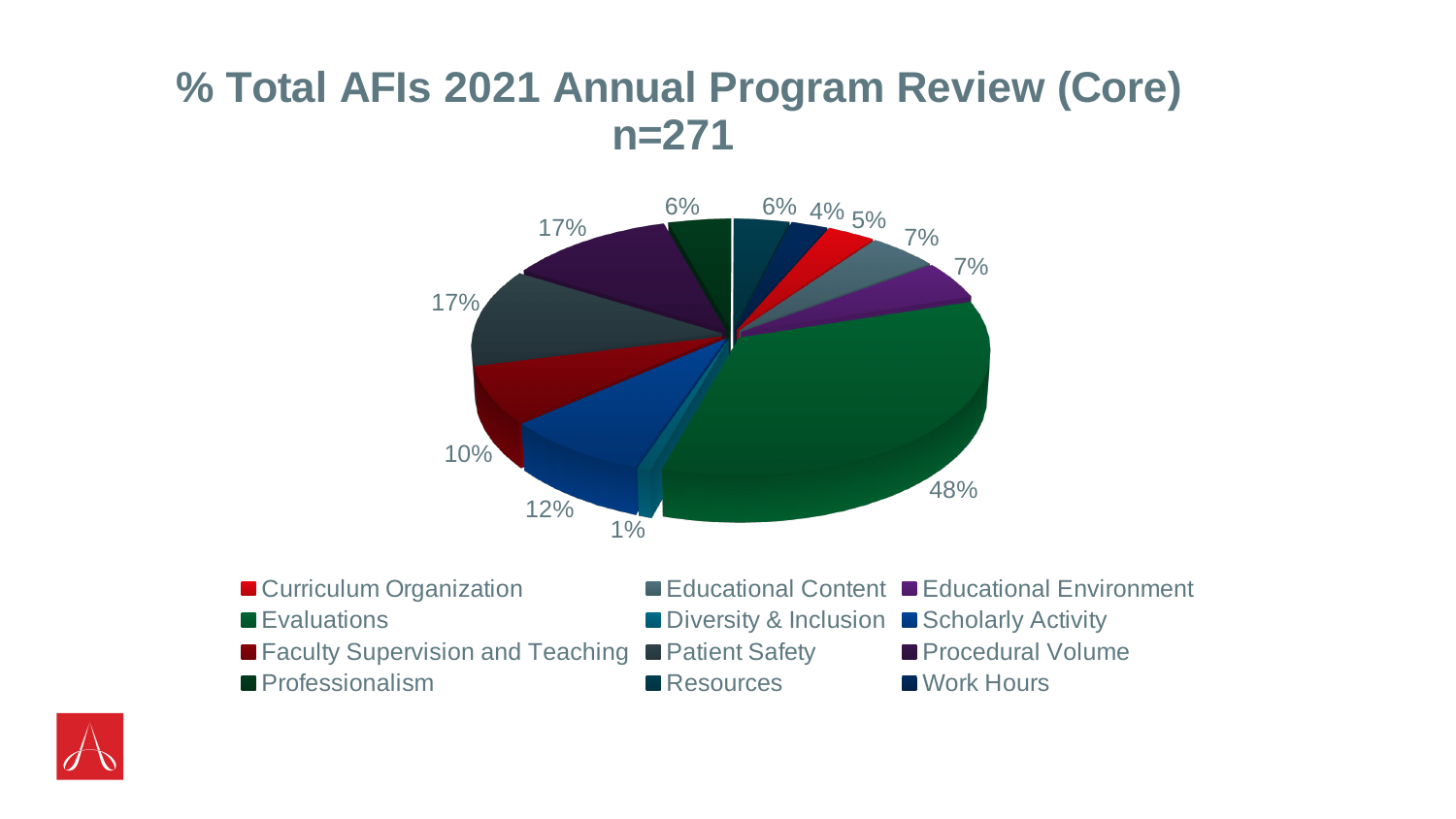
What kind of chart is shown on the slide? Pie chart What percentage is shown for Evaluations? 48% What percentage is shown for Work Hours? 4% What sample size (n) is stated in the chart title? 271 Which is larger, the slice for Scholarly Activity or the slice for Faculty Supervision and Teaching? Scholarly Activity How many categories does the legend list? 12 What is the difference in percentage points between the Evaluations slice and the Patient Safety slice? 31 Which category has the smallest slice of the pie? Diversity & Inclusion Which category has the largest slice of the pie? Evaluations What is the title of the chart? % Total AFIs 2021 Annual Program Review (Core) n=271 What percentage is shown for Faculty Supervision and Teaching? 10% What percentage is shown for Scholarly Activity? 12%